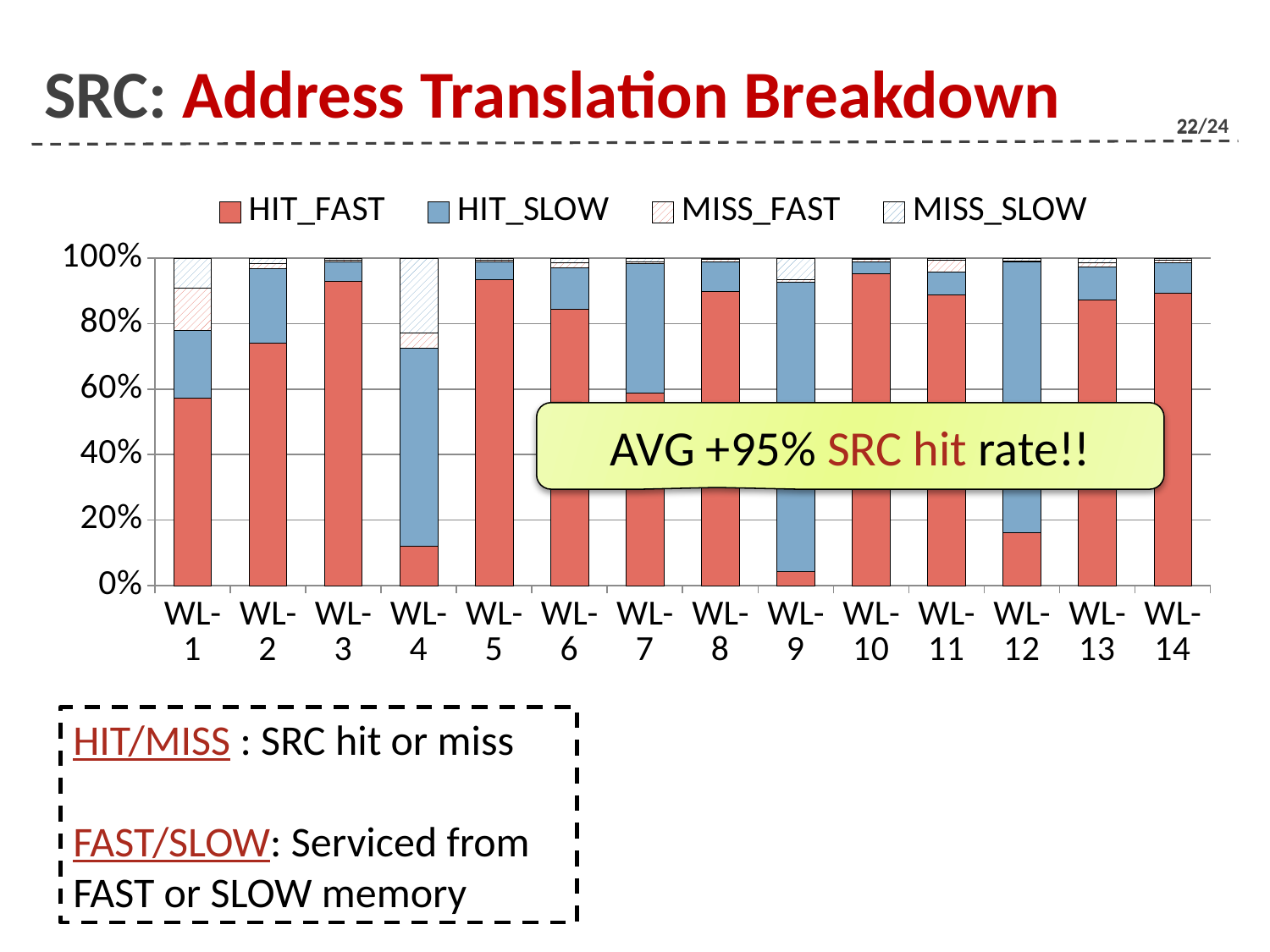
What does each stacked bar total, according to the y axis? 100% How many workload categories are shown on the x axis? 14 Is the HIT_FAST value for WL-3 greater or less than 80%? greater Which legend entry is shown in solid blue? HIT_SLOW Which has the larger HIT_FAST share, WL-3 or WL-4? WL-3 Which workload has the lowest HIT_FAST share? WL-9 Which has the larger HIT_FAST share, WL-12 or WL-2? WL-2 Is the HIT_FAST value for WL-2 greater or less than 60%? greater Is the HIT_FAST value for WL-12 greater or less than 20%? less What kind of chart is shown on the slide? stacked bar chart How many series does the legend list? 4